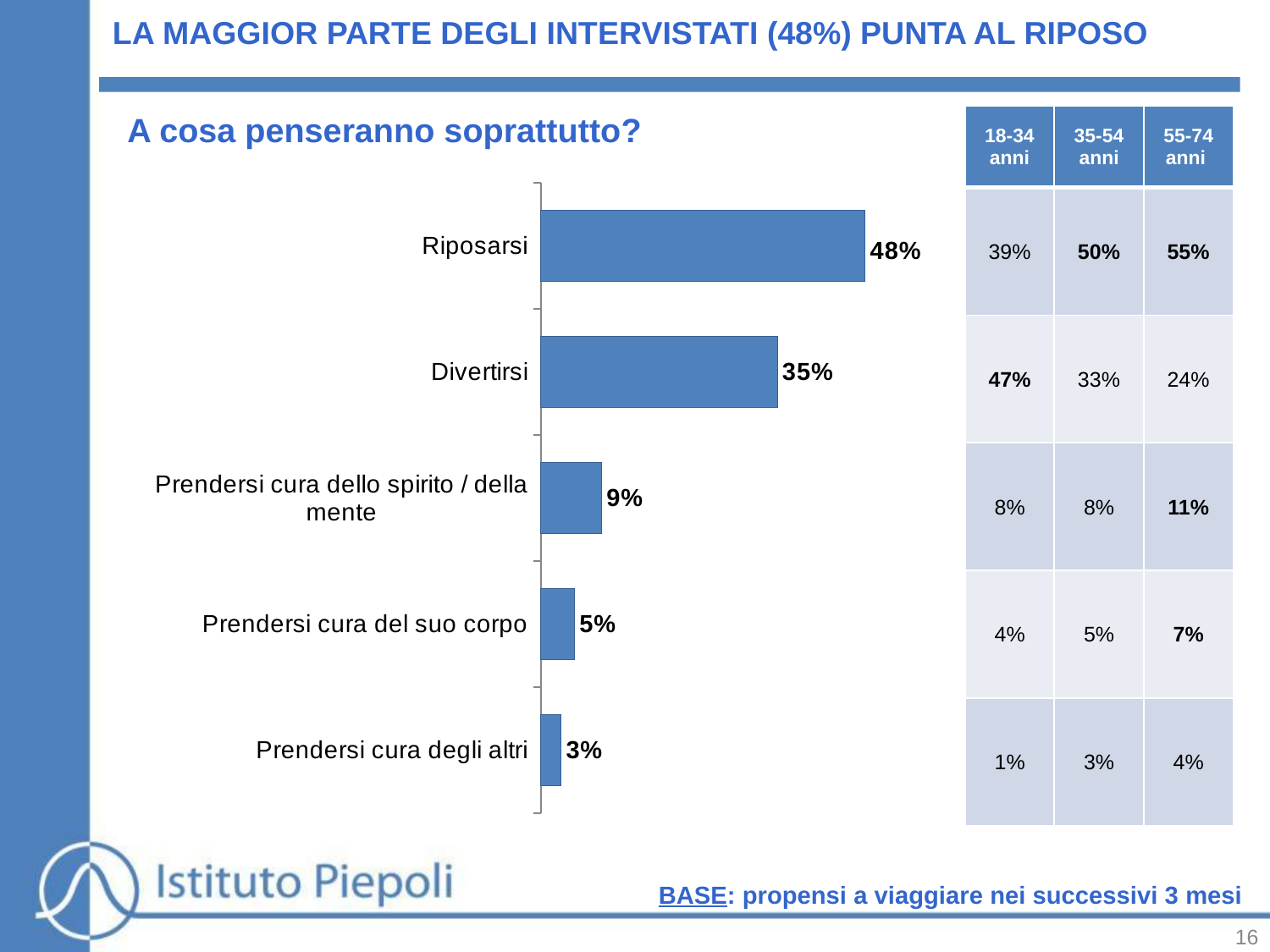
What is the difference between the values for Riposarsi and Divertirsi? 13% What is the value for Prendersi cura dello spirito / della mente? 9% What is the value for Prendersi cura del suo corpo? 5% Which category has the lowest value? Prendersi cura degli altri What kind of chart is shown on the slide? Bar chart What is the question title shown above the chart? A cosa penseranno soprattutto? How many categories are shown in the chart? 5 What is the value for Riposarsi? 48% Which category has the highest value? Riposarsi What is the value for Divertirsi? 35% What is the value for Prendersi cura degli altri? 3% Which is larger, the value for Prendersi cura del suo corpo or the value for Prendersi cura degli altri? Prendersi cura del suo corpo